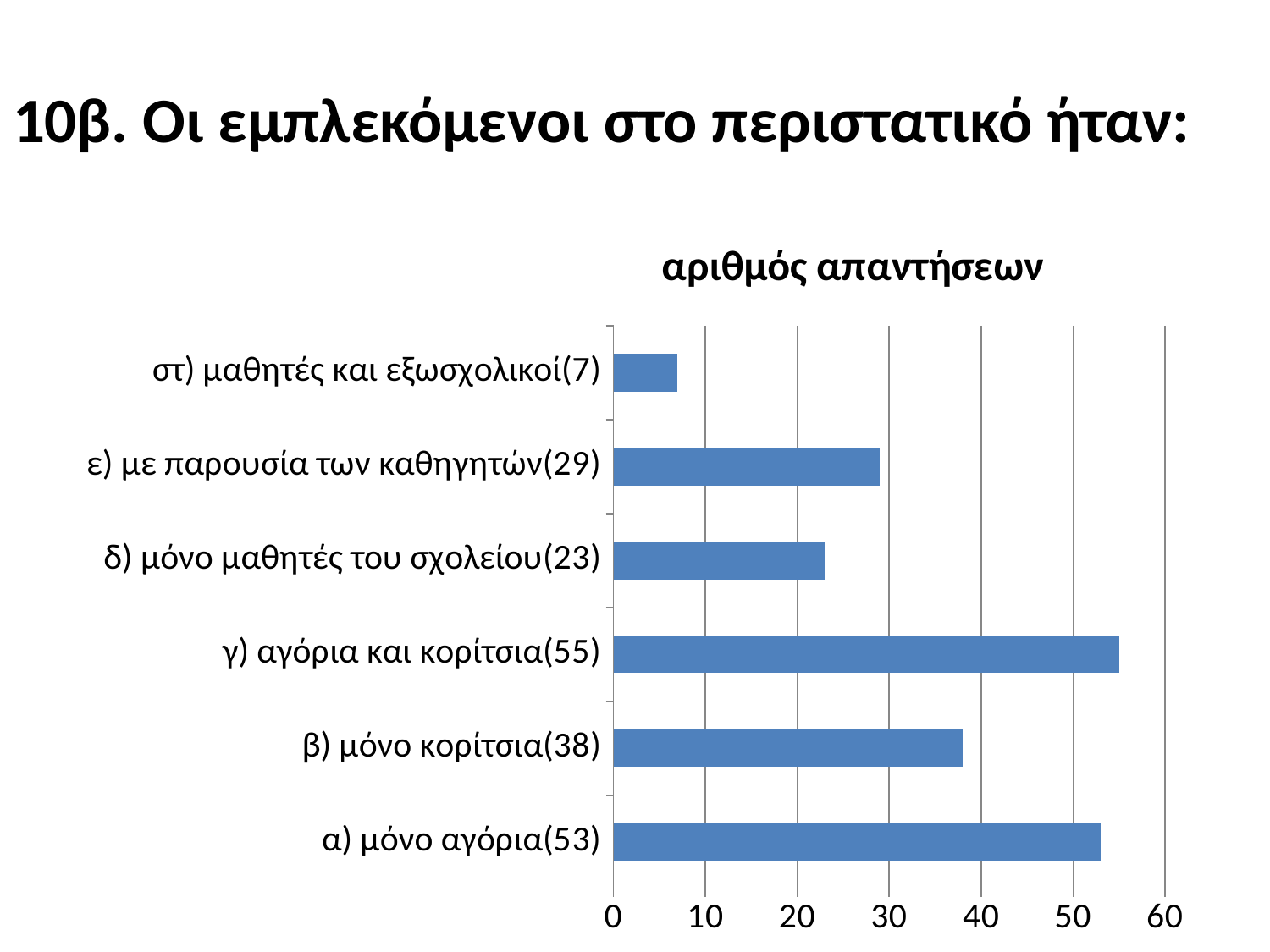
What is the value for "γ) αγόρια και κορίτσια"? 55 How many categories are shown in the chart? 6 Which category has the lowest number of responses? στ) μαθητές και εξωσχολικοί(7) What is the difference between the values for "α) μόνο αγόρια" and "β) μόνο κορίτσια"? 15 Is the value for "α) μόνο αγόρια" greater or less than 50? greater What is the title of the chart? αριθμός απαντήσεων Which is larger, the value for "β) μόνο κορίτσια" or the value for "δ) μόνο μαθητές του σχολείου"? β) μόνο κορίτσια What is the difference between the values for "ε) με παρουσία των καθηγητών" and "δ) μόνο μαθητές του σχολείου"? 6 Which category has the highest number of responses? γ) αγόρια και κορίτσια(55) What is the value for "στ) μαθητές και εξωσχολικοί"? 7 What is the value for "ε) με παρουσία των καθηγητών"? 29 What kind of chart is shown on the slide? bar chart